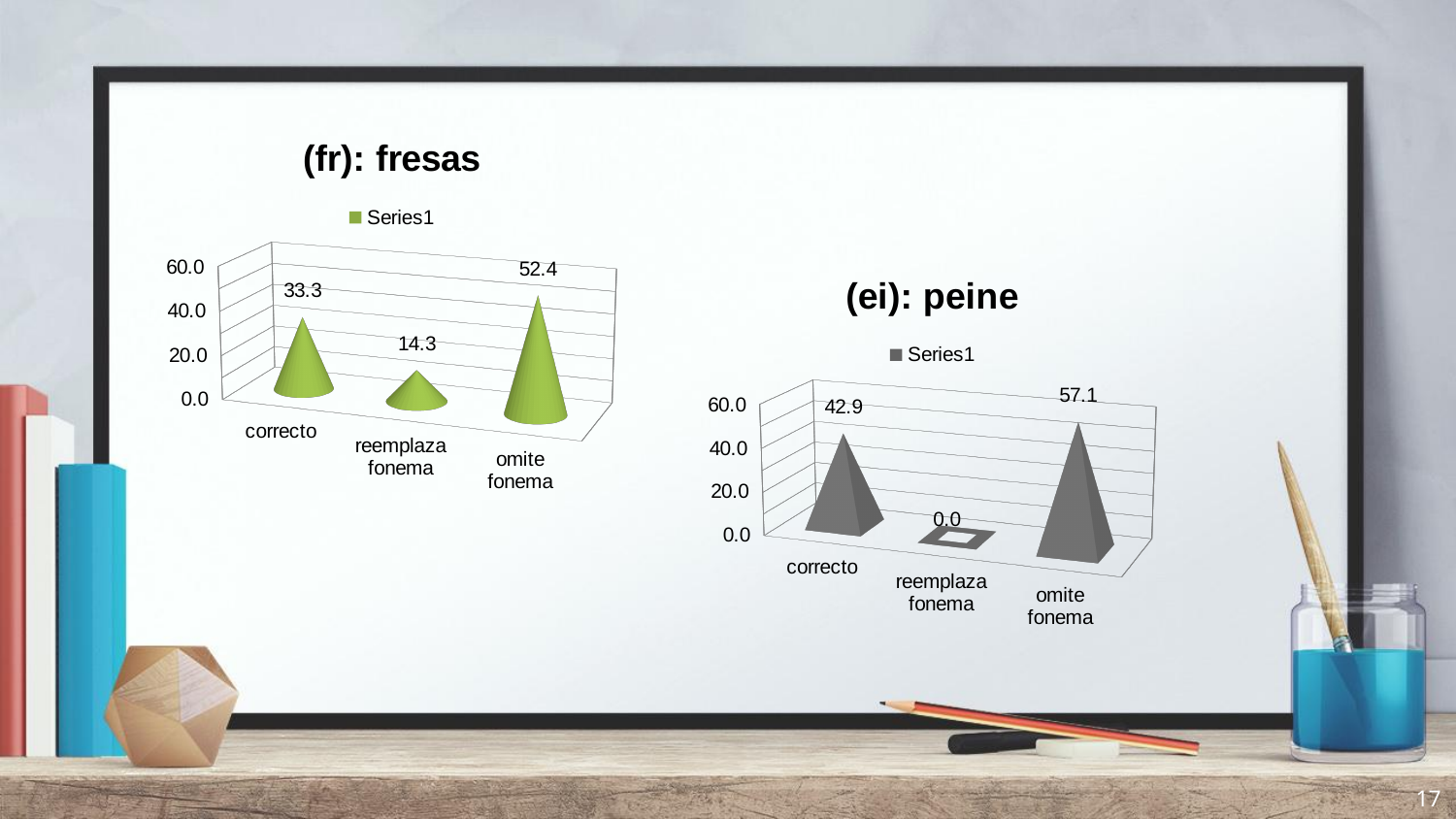
In the "(fr): fresas" chart, which is larger, the value for "correcto" or the value for "reemplaza fonema"? correcto In the "(fr): fresas" chart, what is the value for "reemplaza fonema"? 14.3 In the "(ei): peine" chart, what is the value for "reemplaza fonema"? 0.0 In the "(ei): peine" chart, what is the difference between the values for "omite fonema" and "correcto"? 14.2 In the "(ei): peine" chart, what is the value for "correcto"? 42.9 How many series does the legend of the "(ei): peine" chart list? 1 In the "(fr): fresas" chart, what is the value for "omite fonema"? 52.4 What kind of chart is the "(fr): fresas" chart? bar chart How many categories are shown in the "(ei): peine" chart? 3 In the "(ei): peine" chart, which category has the lowest value? reemplaza fonema In the "(fr): fresas" chart, which category has the highest value? omite fonema In the "(fr): fresas" chart, what is the difference between the values for "omite fonema" and "correcto"? 19.1